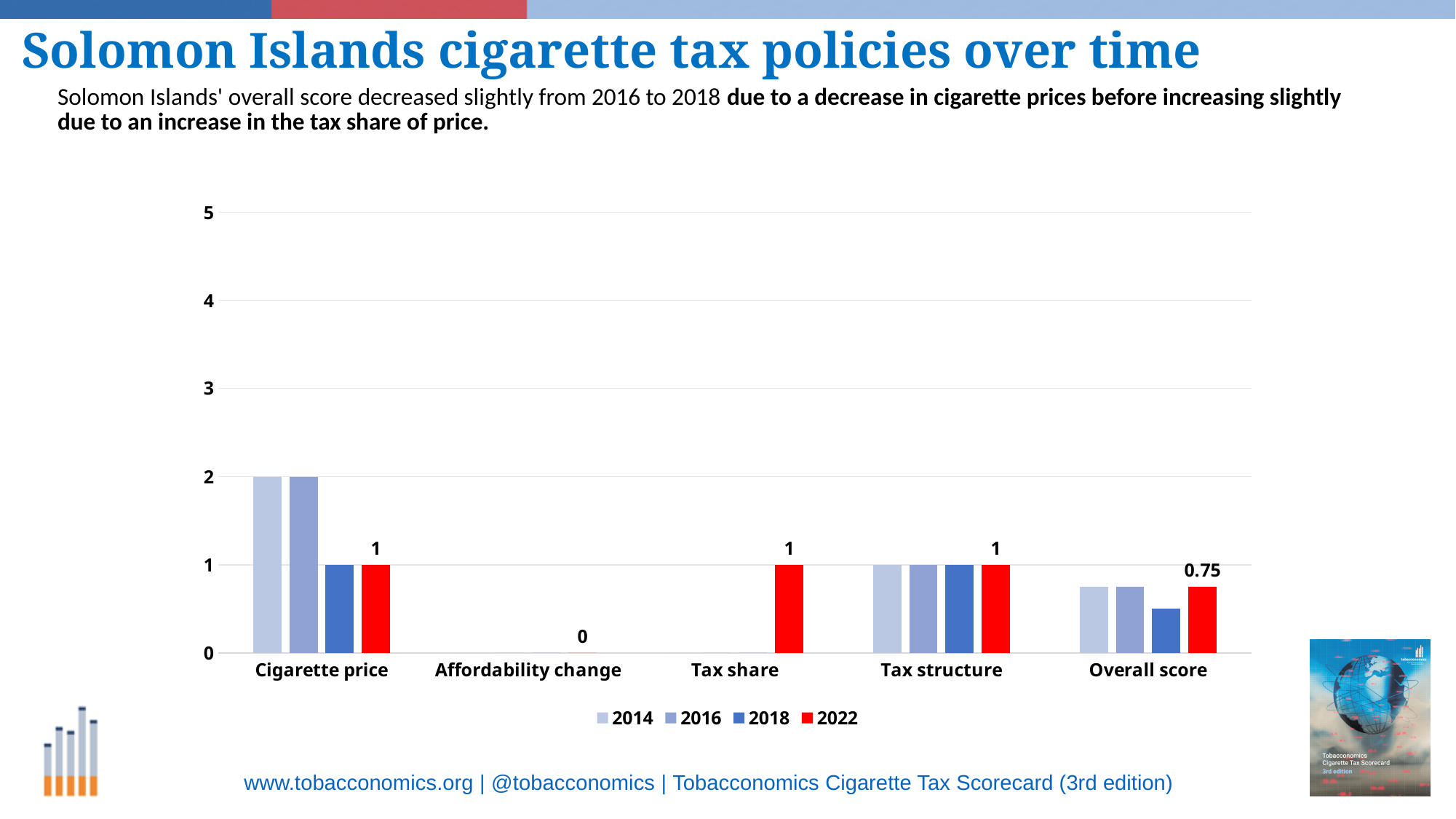
How many categories are shown along the x axis? 5 What is the 2022 value for Overall score? 0.75 For Overall score, which is larger: the 2018 value or the 2022 value? 2022 Which colour represents the 2022 series in the legend? red What is the 2018 value for Cigarette price? 1 What is the 2014 value for Cigarette price? 2 What type of chart is shown on the slide? bar chart Which category has the lowest 2022 value? Affordability change Is the 2018 value for Overall score greater or less than 1? less What is the 2022 value for Affordability change? 0 What is the difference between the 2014 and 2022 values for Cigarette price? 1 How many series does the legend list? 4